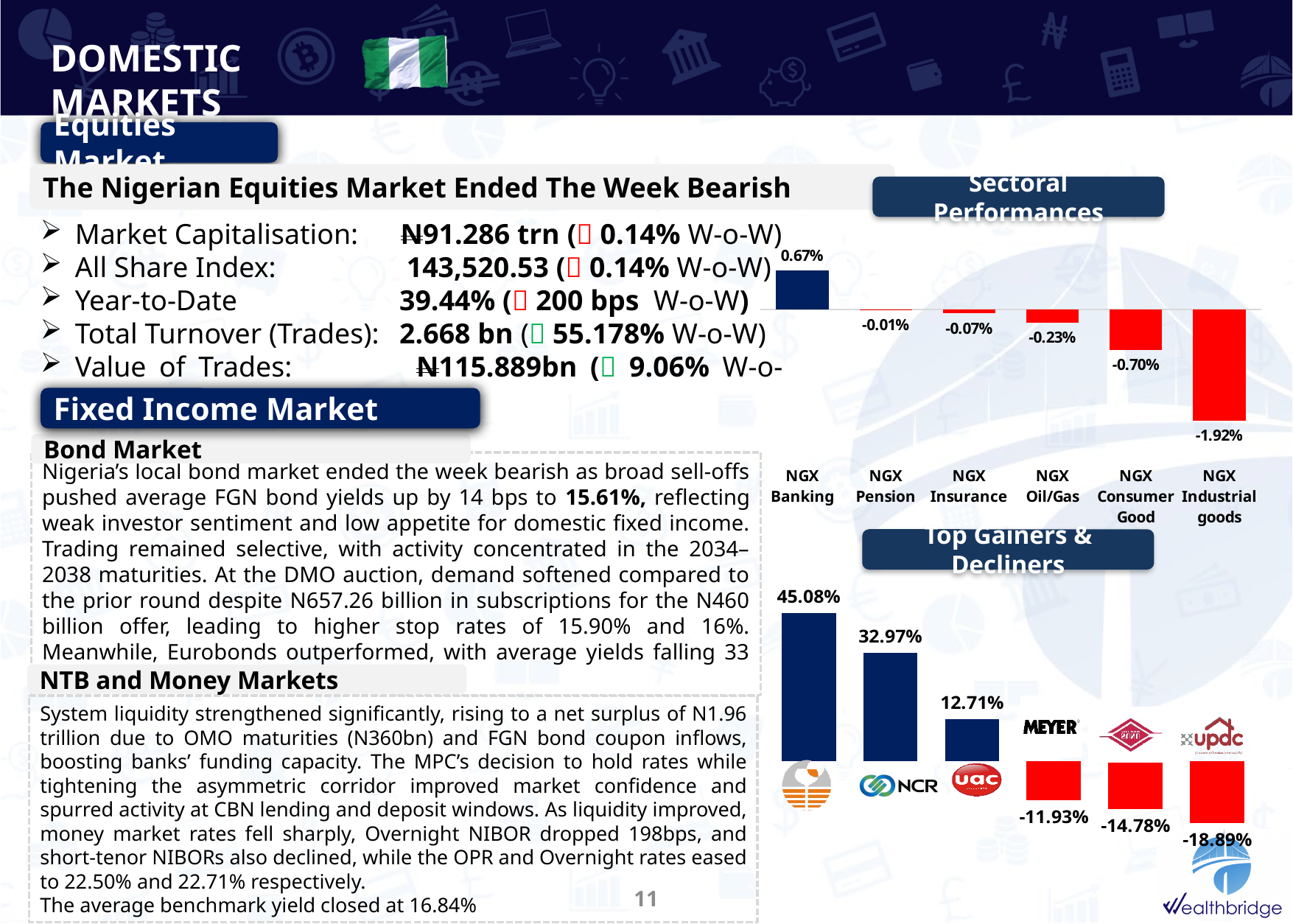
What kind of chart is the Sectoral Performances chart? Bar chart In the Sectoral Performances chart, what is the value for NGX Consumer Good? -0.70% In the Sectoral Performances chart, what is the value for NGX Industrial goods? -1.92% In the Sectoral Performances chart, which sector has the highest value? NGX Banking In the Sectoral Performances chart, which sector has the lowest value? NGX Industrial goods In the Top Gainers & Decliners chart, what is the highest value shown? 45.08% In the Sectoral Performances chart, how many sectors are shown? 6 In the Sectoral Performances chart, what is the value for NGX Banking? 0.67% In the Sectoral Performances chart, what is the difference between the values for NGX Oil/Gas and NGX Consumer Good? 0.47% In the Sectoral Performances chart, which is larger, the value for NGX Insurance or the value for NGX Oil/Gas? NGX Insurance